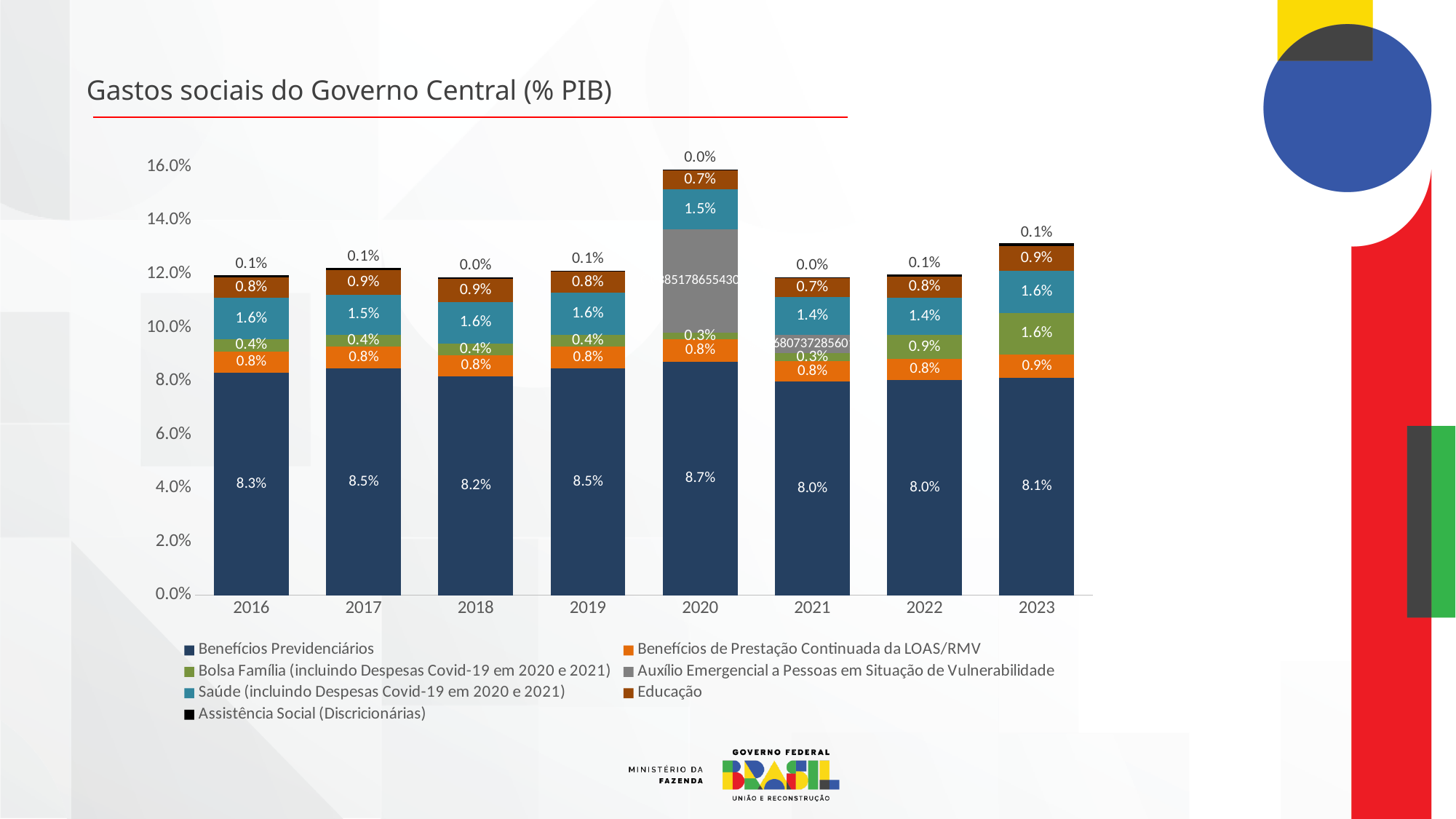
What kind of chart is shown on the slide? Stacked bar chart Is the total height of the 2020 bar greater or less than 14.0%? greater What is the title of the chart? Gastos sociais do Governo Central (% PIB) How many years are shown on the x axis of the chart? 8 What is the value of Benefícios Previdenciários in 2020? 8.7% What is the difference between the Benefícios Previdenciários values for 2017 and 2021? 0.5 percentage points Which year has the larger Educação value, 2016 or 2017? 2017 What is the value of Saúde in 2021? 1.4% How many series does the chart legend list? 7 What is the value of Bolsa Família in 2023? 1.6% What is the value of Educação in 2020? 0.7% In which year is the Benefícios Previdenciários segment highest? 2020